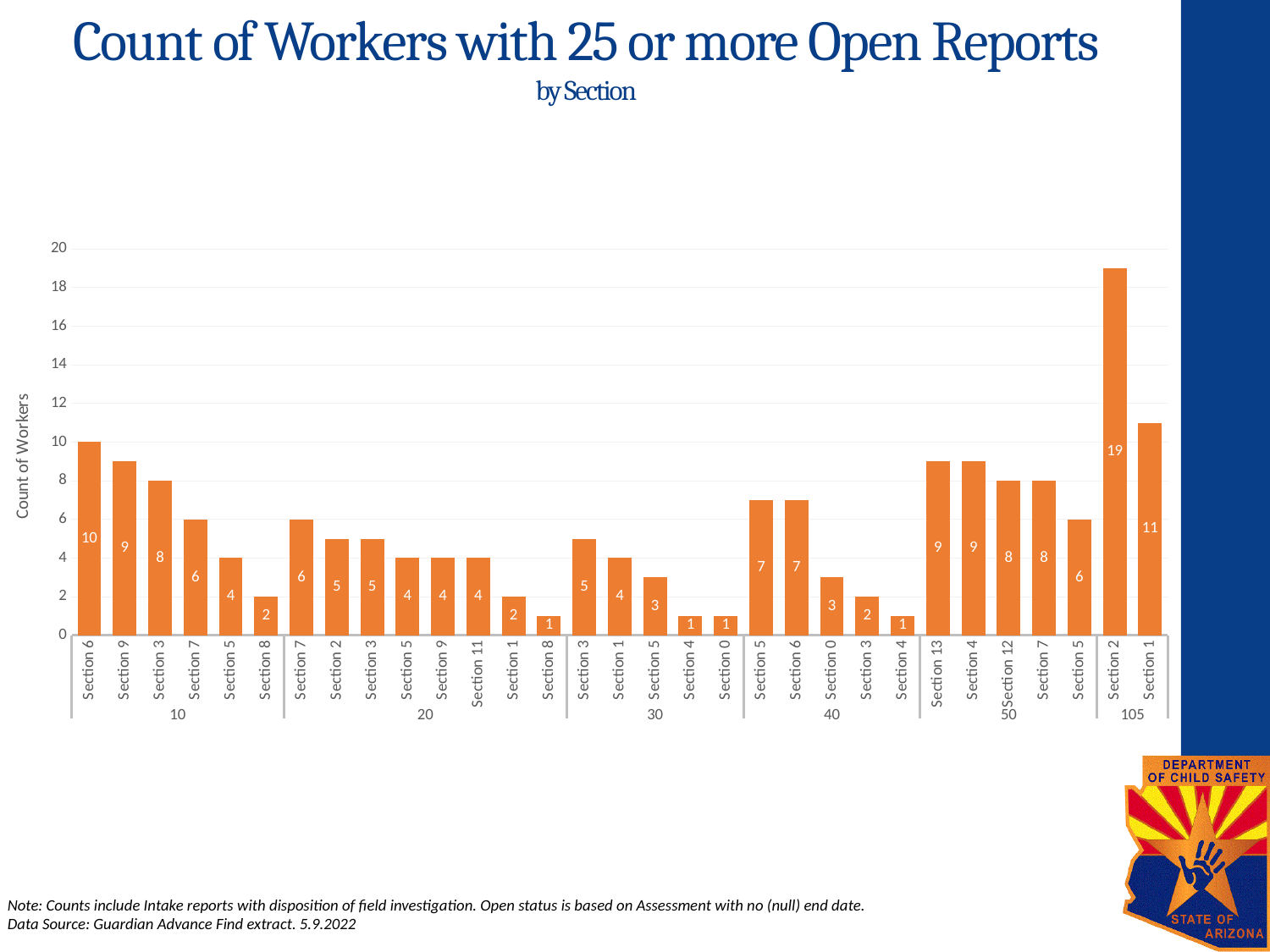
Which bar has the highest count of workers? Section 2 (105) What is the label of the vertical axis? Count of Workers What is the count of workers for Section 2 in group 105? 19 Is the count for Section 2 in group 105 greater or less than 18? greater What is the count of workers for Section 6 in group 10? 10 Within group 40, which section has the lowest count of workers? Section 4 What kind of chart is shown on the slide? Bar chart Which is larger: the count for Section 5 in group 40 or the count for Section 5 in group 50? Section 5 in group 40 What is the difference between the counts for Section 2 and Section 1 in group 105? 8 What is the count of workers for Section 13 in group 50? 9 What is the total count of workers across the two sections in group 105? 30 How many bars are plotted in the chart? 31